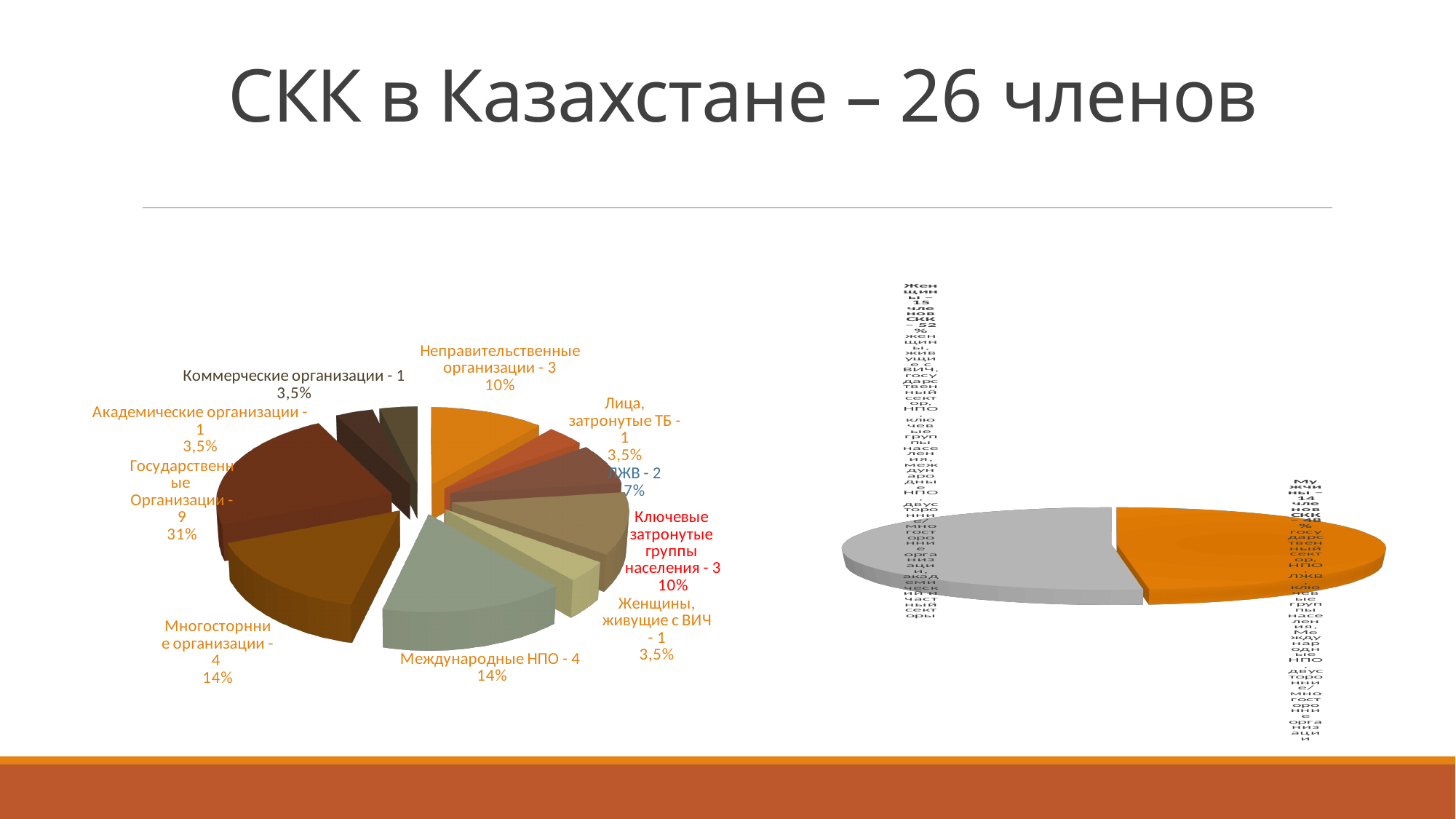
In the left pie chart, how many members are listed for Международные НПО? 4 What kind of chart is the chart on the left of the slide? pie chart In the right pie chart, what percentage share is shown for Женщины? 52% In the left pie chart, which is larger: the share of Неправительственные организации or the share of Многосторонние организации? Многосторонние организации In the left pie chart, what is the difference in percentage points between Государственные Организации and Международные НПО? 17 In the left pie chart, what percentage is shown for ЛЖВ? 7% In the left pie chart, how many categories have a share of 3,5%? 4 In the left pie chart, which category has the largest share? Государственные Организации In the left pie chart, what percentage share do Государственные Организации have? 31% What is the title of the slide? СКК в Казахстане – 26 членов In the left pie chart, how many categories are shown? 10 In the right pie chart, how many members are listed for Мужчины? 14